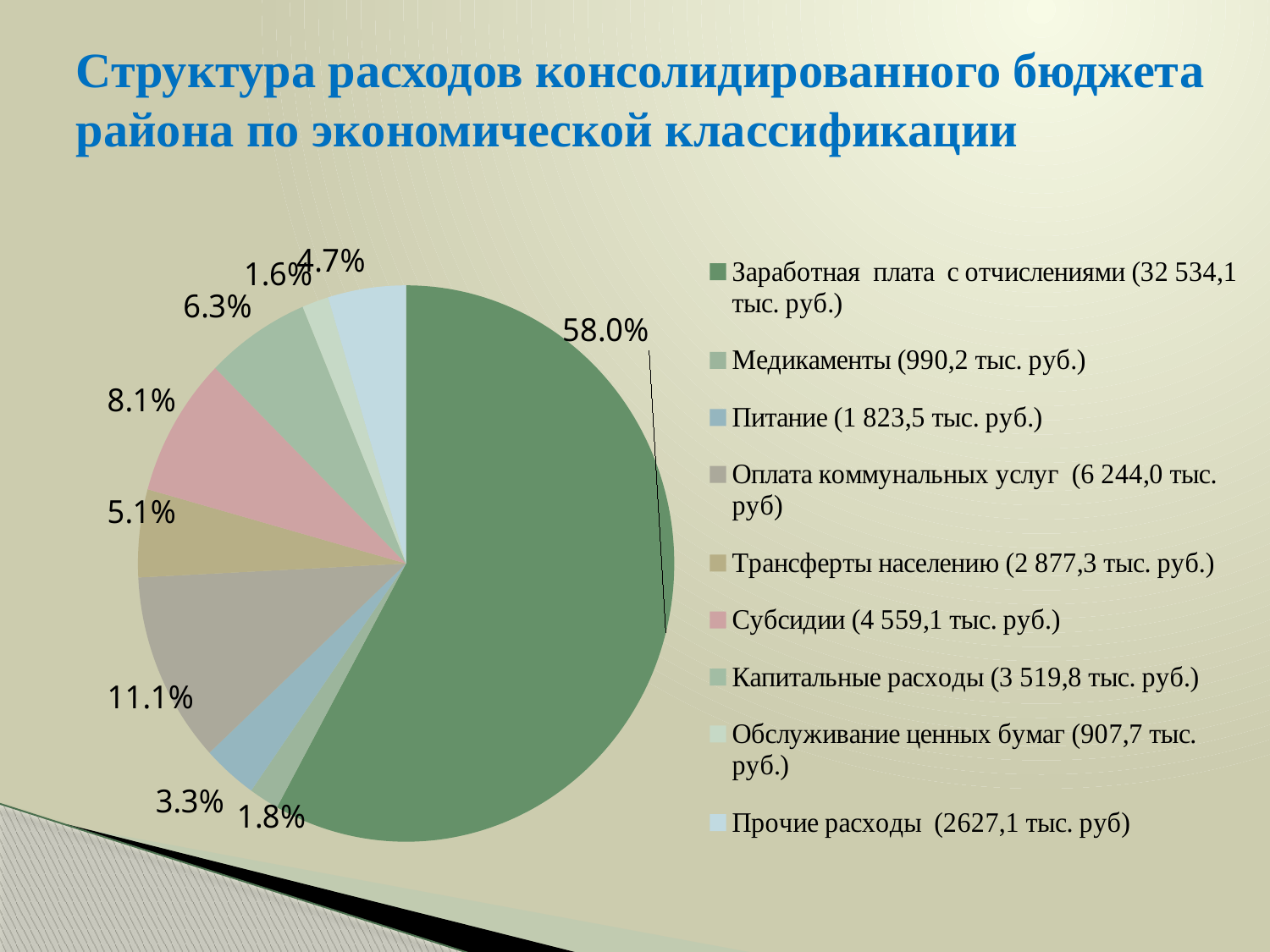
What share of the pie does "Субсидии" take? 8.1% How many slices does the pie chart have? 9 Which category has the largest slice of the pie? Заработная плата с отчислениями Which category has the smallest slice of the pie? Обслуживание ценных бумаг What kind of chart is shown on the slide? pie chart Which slice is larger: "Трансферты населению" or "Прочие расходы"? Трансферты населению What share of the pie does "Оплата коммунальных услуг" take? 11.1% What is the difference in percentage points between the "Оплата коммунальных услуг" slice and the "Капитальные расходы" slice? 4.8% What share of the pie does "Заработная плата с отчислениями" take? 58.0% What amount in thousand rubles is given in the legend for "Капитальные расходы"? 3 519,8 тыс. руб. What amount in thousand rubles is given in the legend for "Питание"? 1 823,5 тыс. руб.